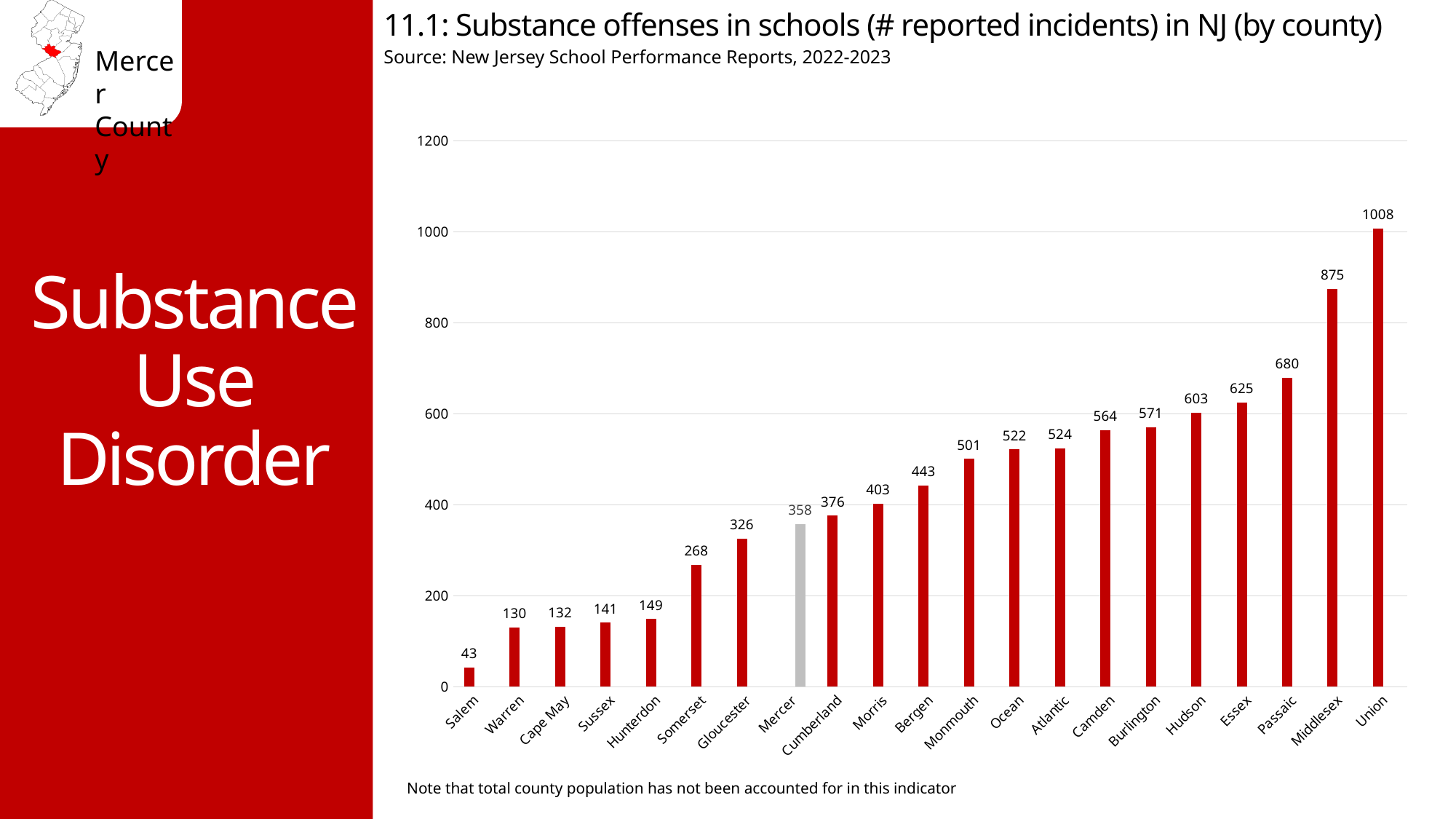
Do the values rise or fall moving from left to right along the x axis? Rise Which has more reported incidents, Bergen or Morris? Bergen Which county has the lowest number of reported incidents? Salem What is the value shown for Middlesex? 875 How many reported substance offense incidents in schools does the chart show for Mercer County? 358 How many counties are shown on the x axis of the chart? 21 Is the value for Passaic greater or less than 600? greater What is the difference between the values for Mercer and Gloucester? 32 Which bar is coloured grey instead of red? Mercer What is the difference between the values for Union and Middlesex? 133 What kind of chart is shown on the slide? Bar chart Which county has the highest number of reported incidents? Union